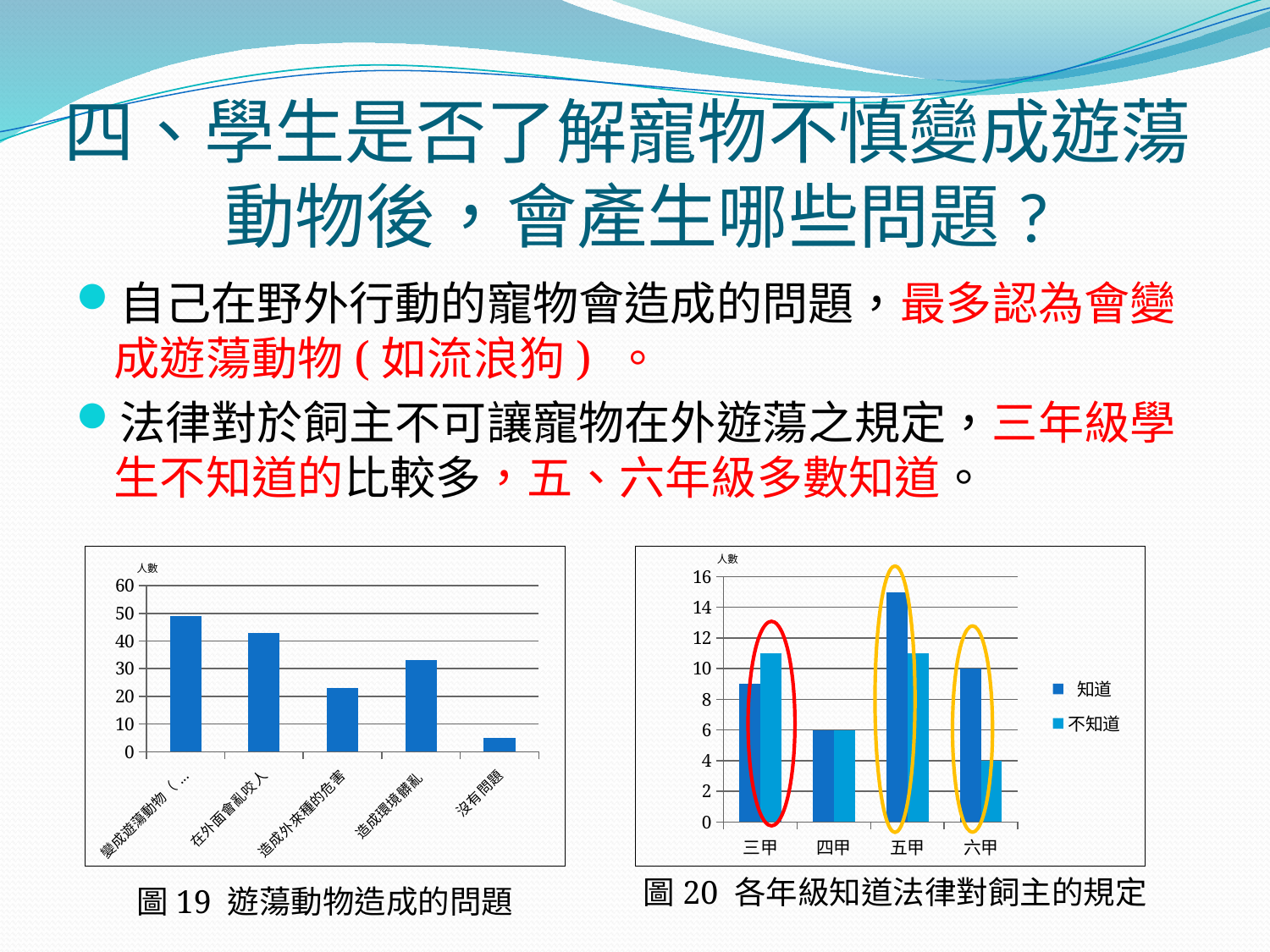
In 圖 20 各年級知道法律對飼主的規定 (the right chart), what is the 不知道 value for 四甲? 6 In 圖 20 各年級知道法律對飼主的規定 (the right chart), which grade has the highest 知道 value? 五甲 In 圖 20 各年級知道法律對飼主的規定 (the right chart), is the 知道 value for 五甲 greater or less than 14? greater In 圖 19 遊蕩動物造成的問題 (the left chart), is the value for 造成外來種的危害 greater or less than 30? less In 圖 20 各年級知道法律對飼主的規定 (the right chart), what is the difference between the 知道 and 不知道 values for 六甲? 6 In 圖 19 遊蕩動物造成的問題 (the left chart), which category has the lowest value? 沒有問題 How many categories are shown in 圖 19 遊蕩動物造成的問題 (the left chart)? 5 In 圖 19 遊蕩動物造成的問題 (the left chart), which category has the highest value? 變成遊蕩動物 What kind of chart is 圖 19 遊蕩動物造成的問題 (the left chart)? bar chart In 圖 19 遊蕩動物造成的問題 (the left chart), which is larger: 在外面會亂咬人 or 造成環境髒亂? 在外面會亂咬人 In 圖 20 各年級知道法律對飼主的規定 (the right chart), what is the 知道 value for 六甲? 10 How many series does the legend list in 圖 20 各年級知道法律對飼主的規定 (the right chart)? 2